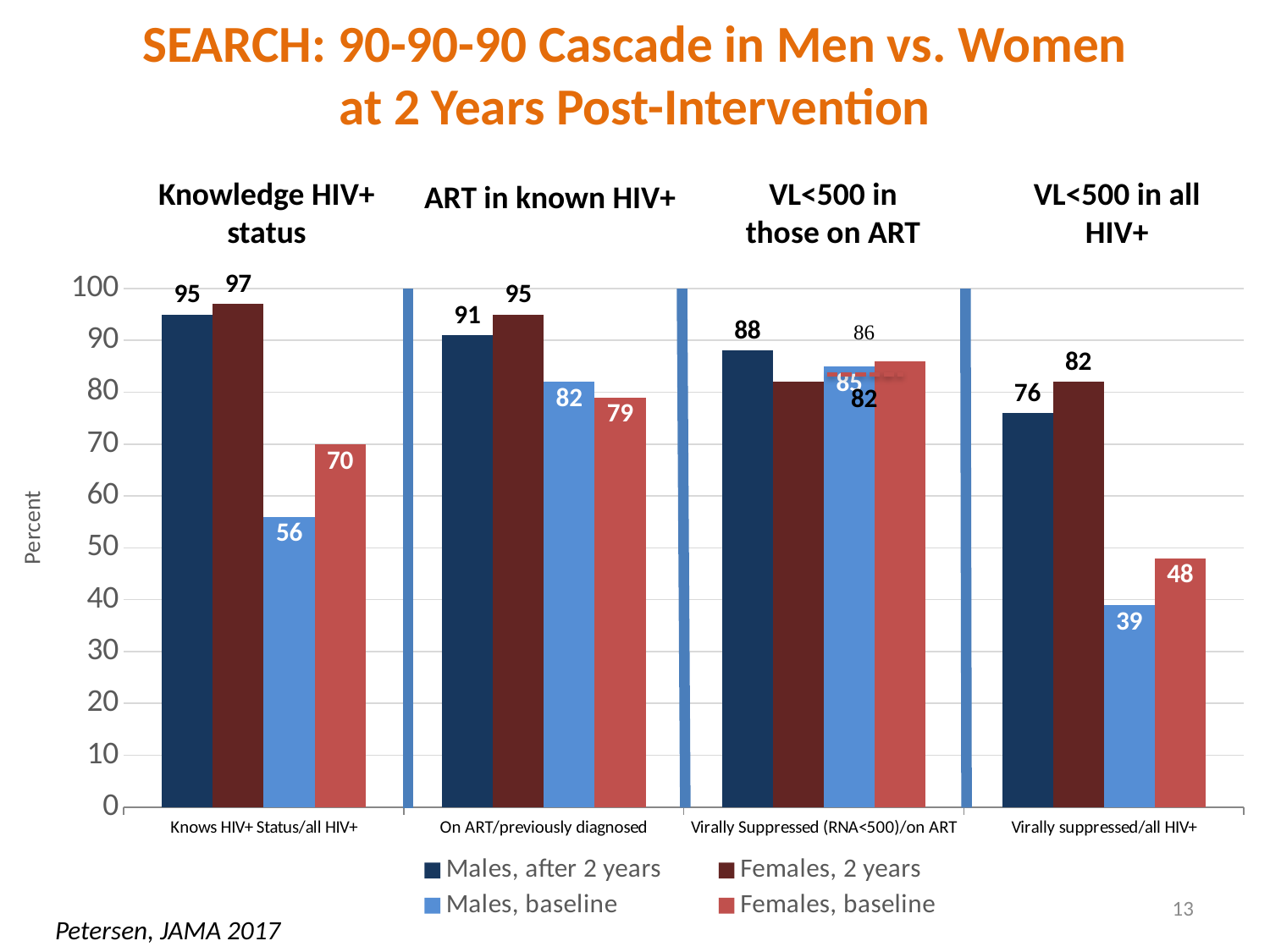
What is the label on the vertical axis? Percent In the On ART/previously diagnosed category, which is larger: Males, baseline or Females, baseline? Males, baseline What is the value for Females, 2 years in the On ART/previously diagnosed category? 95 Which series has the highest value in the Knows HIV+ Status/all HIV+ category? Females, 2 years Which series has the lowest value in the Virally suppressed/all HIV+ category? Males, baseline What is the value for Females, baseline in the Knows HIV+ Status/all HIV+ category? 70 What is the value for Males, baseline in the Virally suppressed/all HIV+ category? 39 In the Knows HIV+ Status/all HIV+ category, what is the difference between Males, after 2 years and Males, baseline? 39 What is the value for Males, after 2 years in the Virally Suppressed (RNA<500)/on ART category? 88 How many series does the legend list? 4 What is the value for Males, after 2 years in the Knows HIV+ Status/all HIV+ category? 95 In the Virally suppressed/all HIV+ category, what is the difference between Females, 2 years and Females, baseline? 34